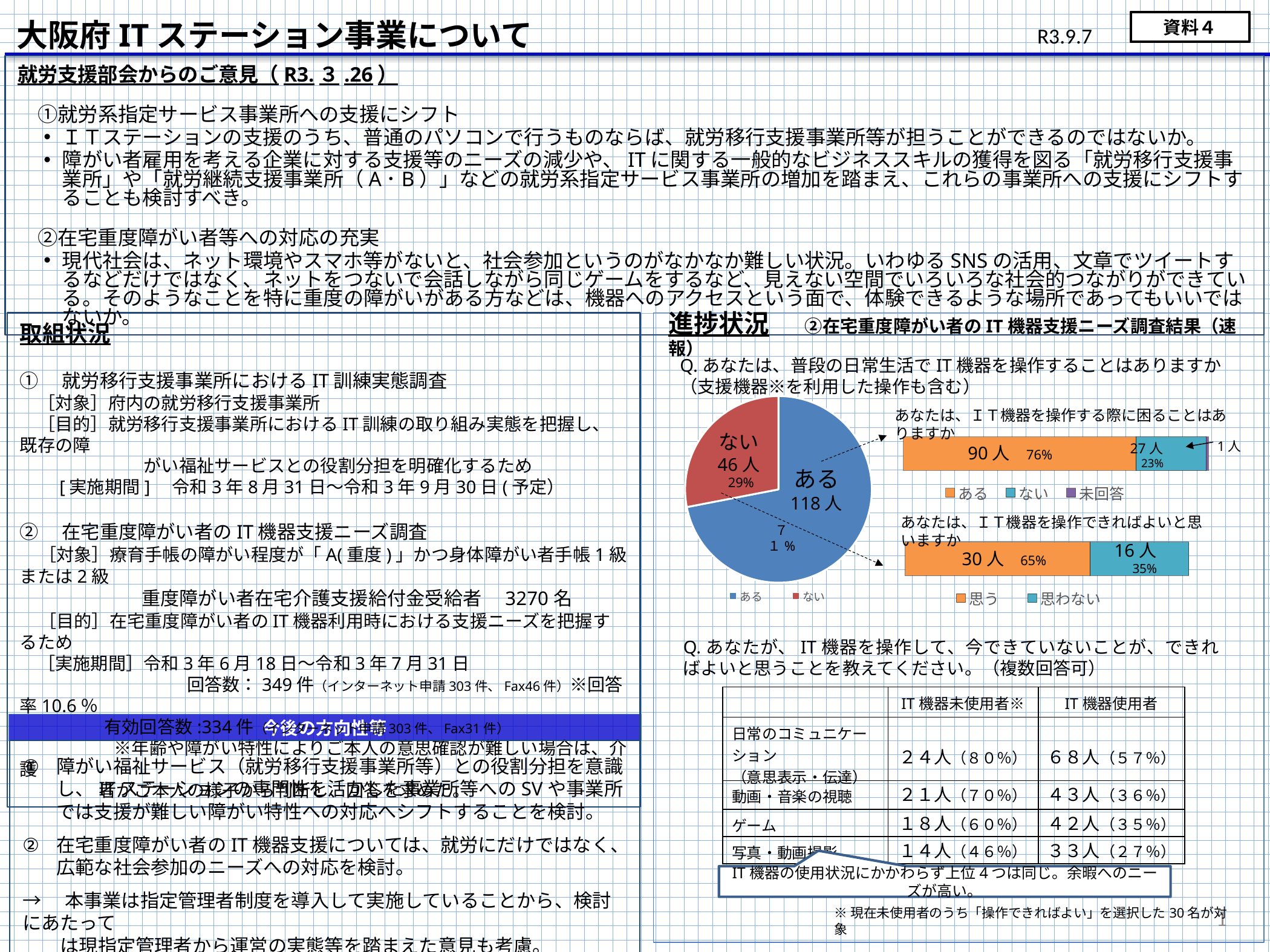
In the bar chart titled あなたは、ＩＴ機器を操作できればよいと思いますか, what is the difference between 思う and 思わない? 14人 In the bar chart titled あなたは、ＩＴ機器を操作する際に困ることはありますか, what is the value for ある? 90人 In the pie chart, which is larger, ある or ない? ある How many slices does the pie chart have? 2 How many series does the legend of the bar chart titled あなたは、ＩＴ機器を操作する際に困ることはありますか list? 3 In the pie chart, what is the difference between the ある and ない counts? 72人 In the bar chart titled あなたは、ＩＴ機器を操作する際に困ることはありますか, what is the total of the stacked bar? 118人 In the bar chart titled あなたは、ＩＴ機器を操作する際に困ることはありますか, what is the value for ない? 27人 What kind of chart shows the ある / ない responses to the question about operating IT devices in daily life? pie chart In the bar chart titled あなたは、ＩＴ機器を操作できればよいと思いますか, what is the value for 思う? 30人 In the pie chart, how many respondents answered ある? 118人 In the pie chart, what percentage share does ない have? 29%